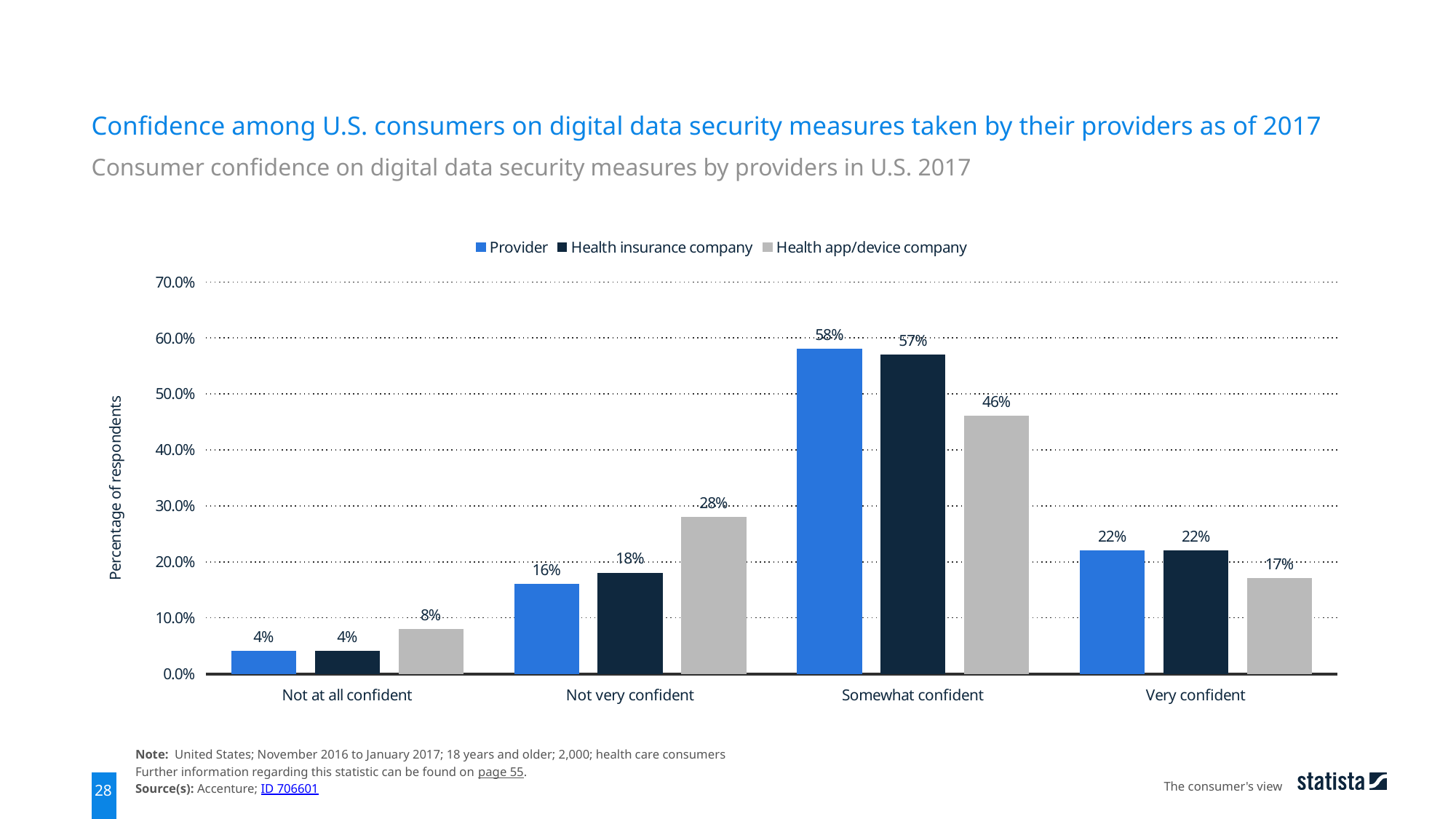
What is the value for Health app/device company in the Not very confident category? 28% What is the label of the y axis? Percentage of respondents How many series does the legend list? 3 Which category has the highest value for the Health app/device company series? Somewhat confident What is the value for Health insurance company in the Very confident category? 22% How many confidence categories are shown on the x axis? 4 What kind of chart is shown on the slide? Bar chart Is the value for Health insurance company in the Somewhat confident category greater or less than 50.0%? greater What is the difference between the Provider and Health app/device company values in the Somewhat confident category? 12% What percentage of respondents were somewhat confident in their provider's digital data security measures? 58% In the Not very confident category, which is larger: the Provider value or the Health app/device company value? Health app/device company Which category has the lowest value for the Provider series? Not at all confident